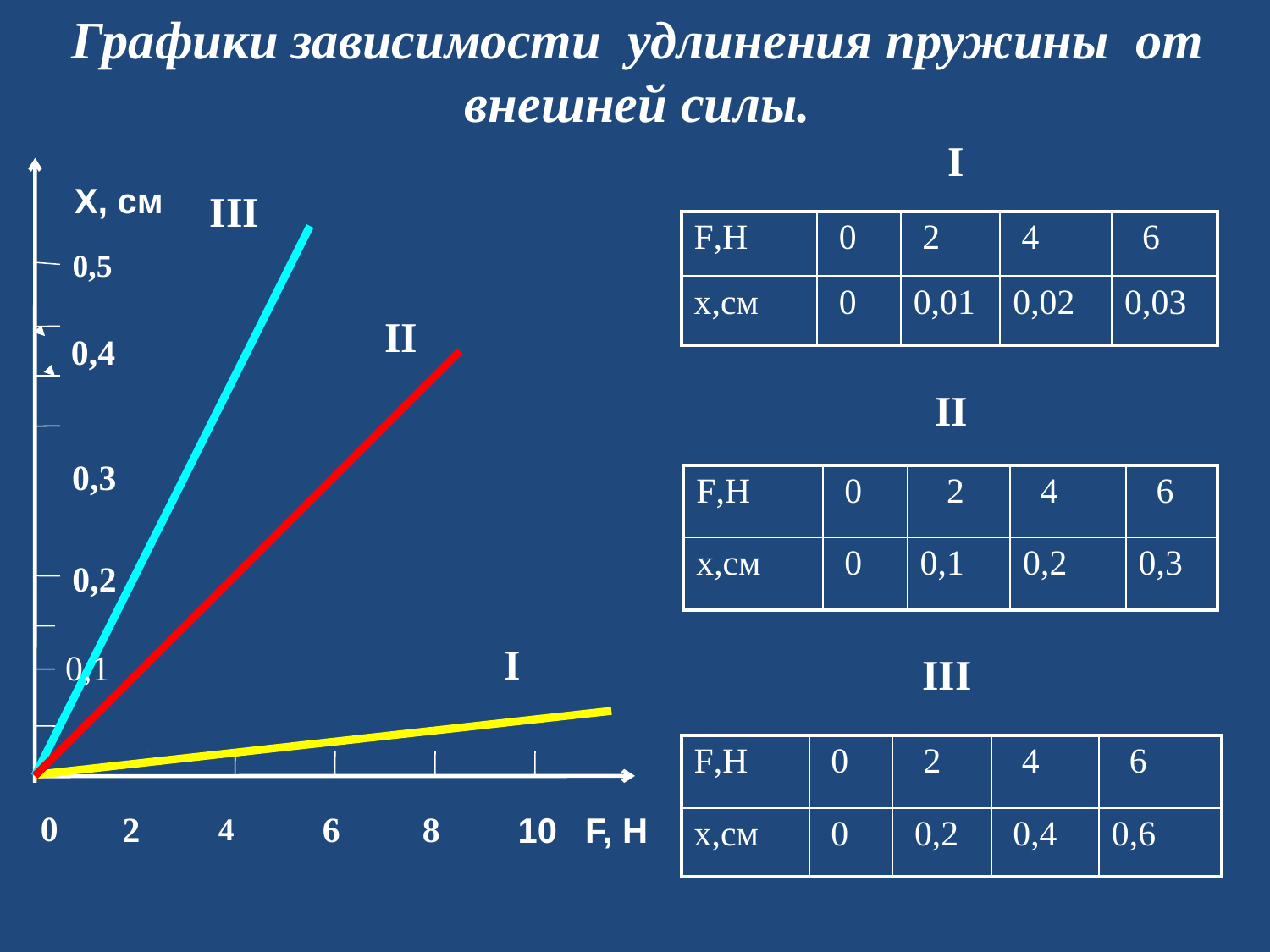
Is the value of x for graph III at F = 4 greater or less than 0,3? greater Do the values of x rise or fall as F increases along the x axis for graph II? rise What colour is the line for graph II on the chart? red According to table I, what is x at F = 2 Н? 0,01 Is the value of x for graph I at F = 10 greater or less than 0,1? less According to table III, what is x at F = 6 Н? 0,6 Which graph on the chart is the least steep? I Which graph on the chart is the steepest? III According to table II, what is x at F = 4 Н? 0,2 What kind of chart is shown on the slide? line chart What is the difference between x for graph III and x for graph II at F = 6 Н, according to the tables? 0,3 How many lines (graphs) are plotted on the chart? 3